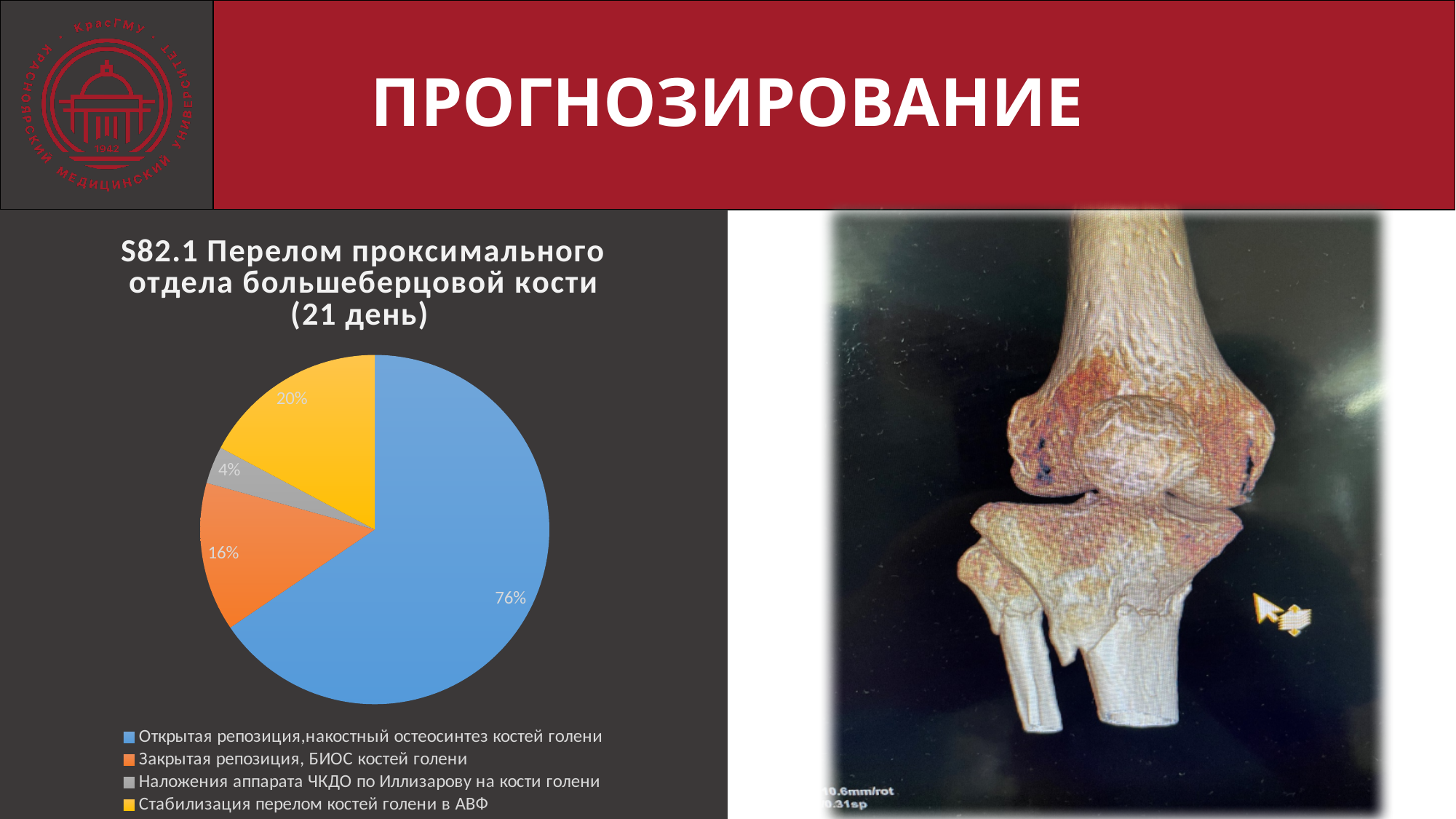
What is the title of the pie chart? S82.1 Перелом проксимального отдела большеберцовой кости (21 день) How many categories does the pie chart legend list? 4 What share of the pie is labelled for "Открытая репозиция,накостный остеосинтез костей голени"? 76% What share of the pie is labelled for "Наложения аппарата ЧКДО по Иллизарову на кости голени"? 4% Which slice is larger: "Закрытая репозиция, БИОС костей голени" or "Стабилизация перелом костей голени в АВФ"? Стабилизация перелом костей голени в АВФ Which category has the smallest slice of the pie? Наложения аппарата ЧКДО по Иллизарову на кости голени What is the difference in percentage points between the "Открытая репозиция,накостный остеосинтез костей голени" slice and the "Закрытая репозиция, БИОС костей голени" slice? 60 What share of the pie is labelled for "Стабилизация перелом костей голени в АВФ"? 20% What kind of chart is shown on the slide? pie chart Which category has the largest slice of the pie? Открытая репозиция,накостный остеосинтез костей голени What colour is the slice for "Наложения аппарата ЧКДО по Иллизарову на кости голени"? grey What share of the pie is labelled for "Закрытая репозиция, БИОС костей голени"? 16%